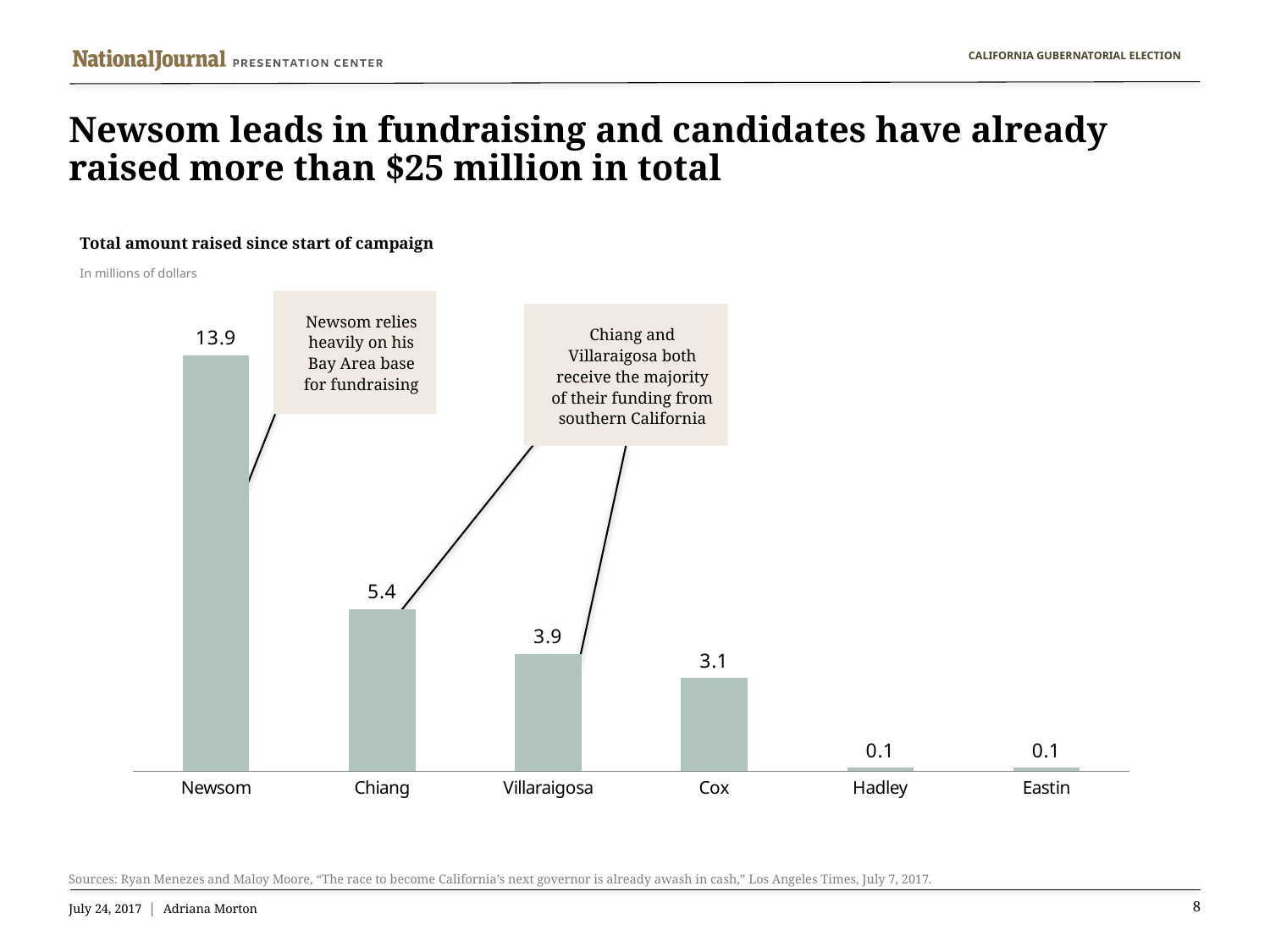
What is the total amount raised by Chiang, in millions of dollars? 5.4 What is the difference between the amounts raised by Newsom and Chiang, in millions of dollars? 8.5 What is the total amount raised by Cox, in millions of dollars? 3.1 Which candidate has raised the most money? Newsom What is the title of the chart? Total amount raised since start of campaign What is the total amount raised by Villaraigosa, in millions of dollars? 3.9 What is the total amount raised by Newsom, in millions of dollars? 13.9 What type of chart is shown on the slide? Bar chart What is the difference between the amounts raised by Villaraigosa and Cox, in millions of dollars? 0.8 What is the total amount raised by Hadley, in millions of dollars? 0.1 Who has raised more, Chiang or Cox? Chiang How many candidates are shown in the chart? 6